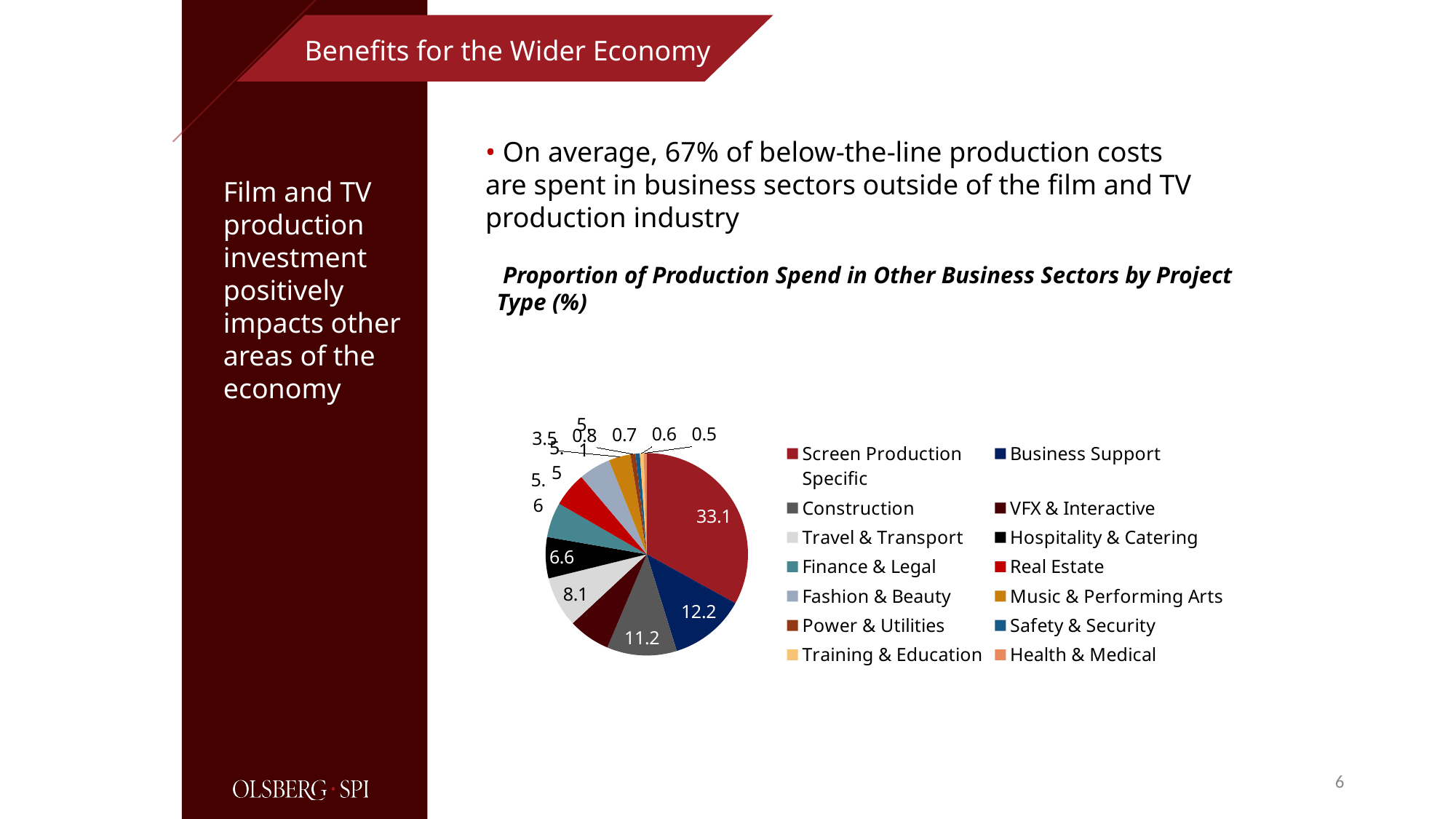
How many sectors are listed in the pie chart's legend? 14 What type of chart is shown on the slide? Pie chart What is the difference between the values for Screen Production Specific and Business Support? 20.9 What is the difference between the values for Construction and Hospitality & Catering? 4.6 What is the value for Business Support in the pie chart? 12.2 Which is larger, the value for Business Support or the value for Construction? Business Support What is the value for Screen Production Specific in the pie chart? 33.1 Which sector has the largest slice of the pie chart? Screen Production Specific What is the title of the pie chart? Proportion of Production Spend in Other Business Sectors by Project Type (%) Which sector is shown in dark red in the pie chart's legend? Screen Production Specific What is the value for Hospitality & Catering in the pie chart? 6.6 What is the value for Construction in the pie chart? 11.2